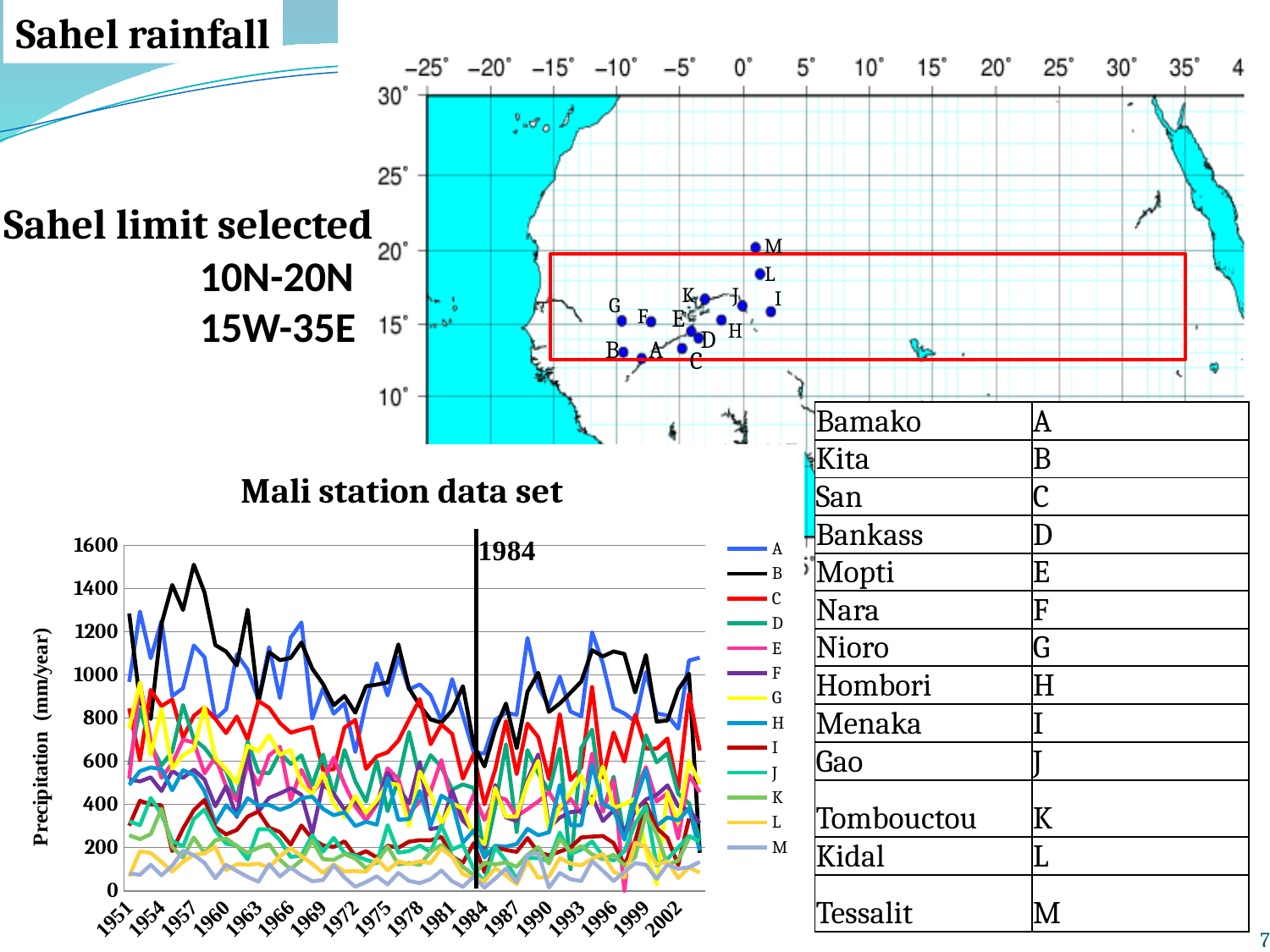
What is the highest tick value shown on the y-axis of the 'Mali station data set' chart? 1600 In the 'Mali station data set' chart, is the peak value of series B around 1957 greater or less than 1400? greater How many series does the legend of the 'Mali station data set' chart list? 13 What kind of chart is the 'Mali station data set' chart? line chart In the 'Mali station data set' chart, which series reaches the highest peak value? B What is the title of the line chart on the slide? Mali station data set In the 'Mali station data set' chart, is the value for series M in 1951 greater or less than 200? less In the 'Mali station data set' chart, which series has the lowest values overall? M What is the y-axis label of the 'Mali station data set' chart? Precipitation (mm/year) In the 'Mali station data set' chart, is the value for series A in 1951 greater or less than 800? greater In the 'Mali station data set' chart, what year is marked by the vertical black line? 1984 In the 'Mali station data set' chart, which series has the larger value in 1951, A or M? A